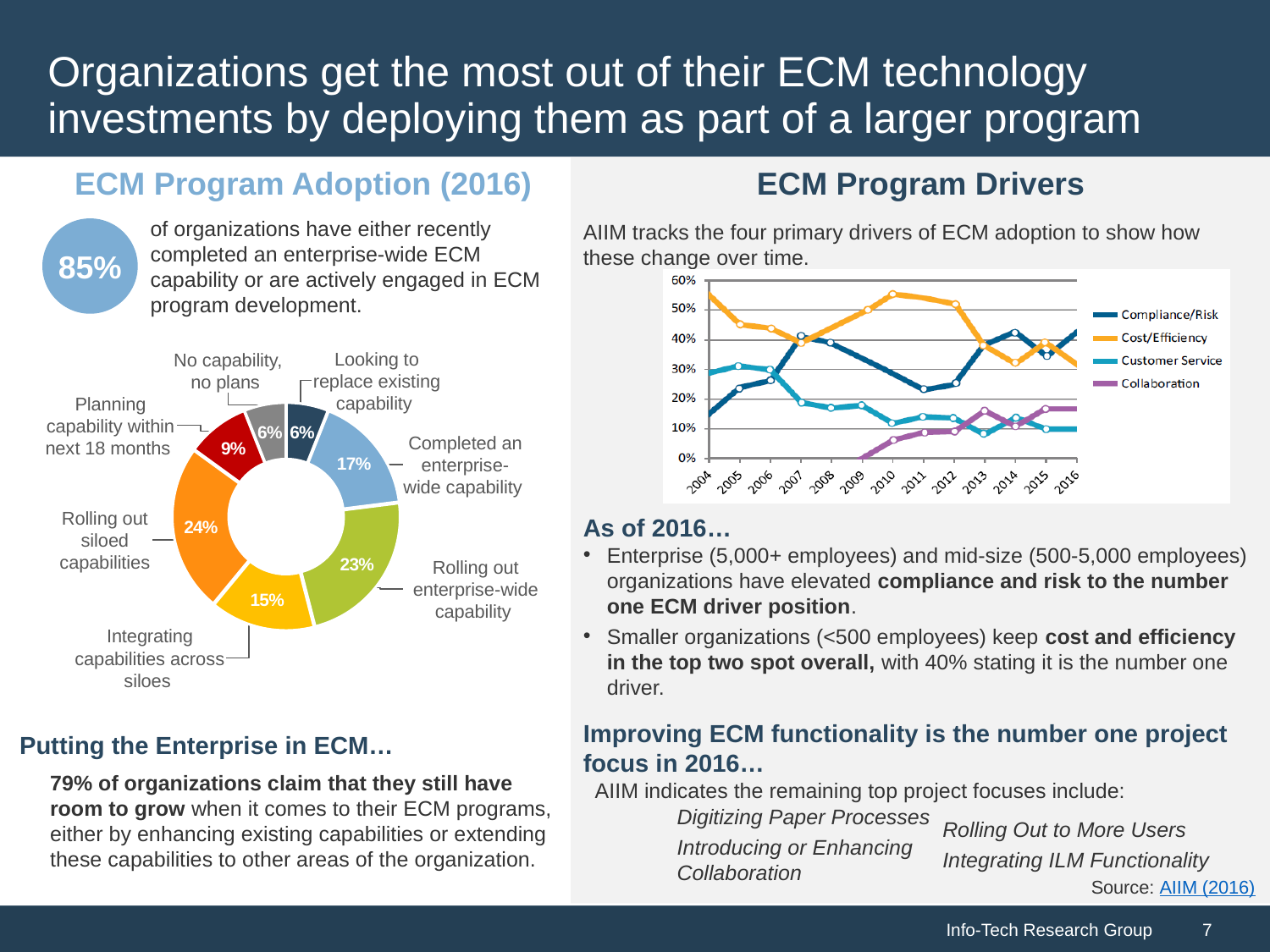
How many categories are shown on the ECM Program Adoption (2016) chart? 7 On the ECM Program Drivers chart, is the value for Compliance/Risk in 2004 greater or less than 20%? less On the ECM Program Adoption (2016) chart, what percentage of organizations are rolling out siloed capabilities? 24% What kind of chart is the ECM Program Adoption (2016) chart? Pie (donut) chart What kind of chart is the ECM Program Drivers chart? Line chart On the ECM Program Drivers chart, is the value for Cost/Efficiency in 2004 greater or less than 50%? greater On the ECM Program Adoption (2016) chart, which is larger: 'Completed an enterprise-wide capability' or 'Integrating capabilities across siloes'? Completed an enterprise-wide capability On the ECM Program Adoption (2016) chart, what is the difference in percentage points between 'Rolling out siloed capabilities' and 'Integrating capabilities across siloes'? 9 On the ECM Program Drivers chart, does the Compliance/Risk series rise or fall overall from 2004 to 2016? Rise How many series does the legend of the ECM Program Drivers chart list? 4 On the ECM Program Adoption (2016) chart, which category has the largest share? Rolling out siloed capabilities On the ECM Program Adoption (2016) chart, what share is shown for 'Completed an enterprise-wide capability'? 17%